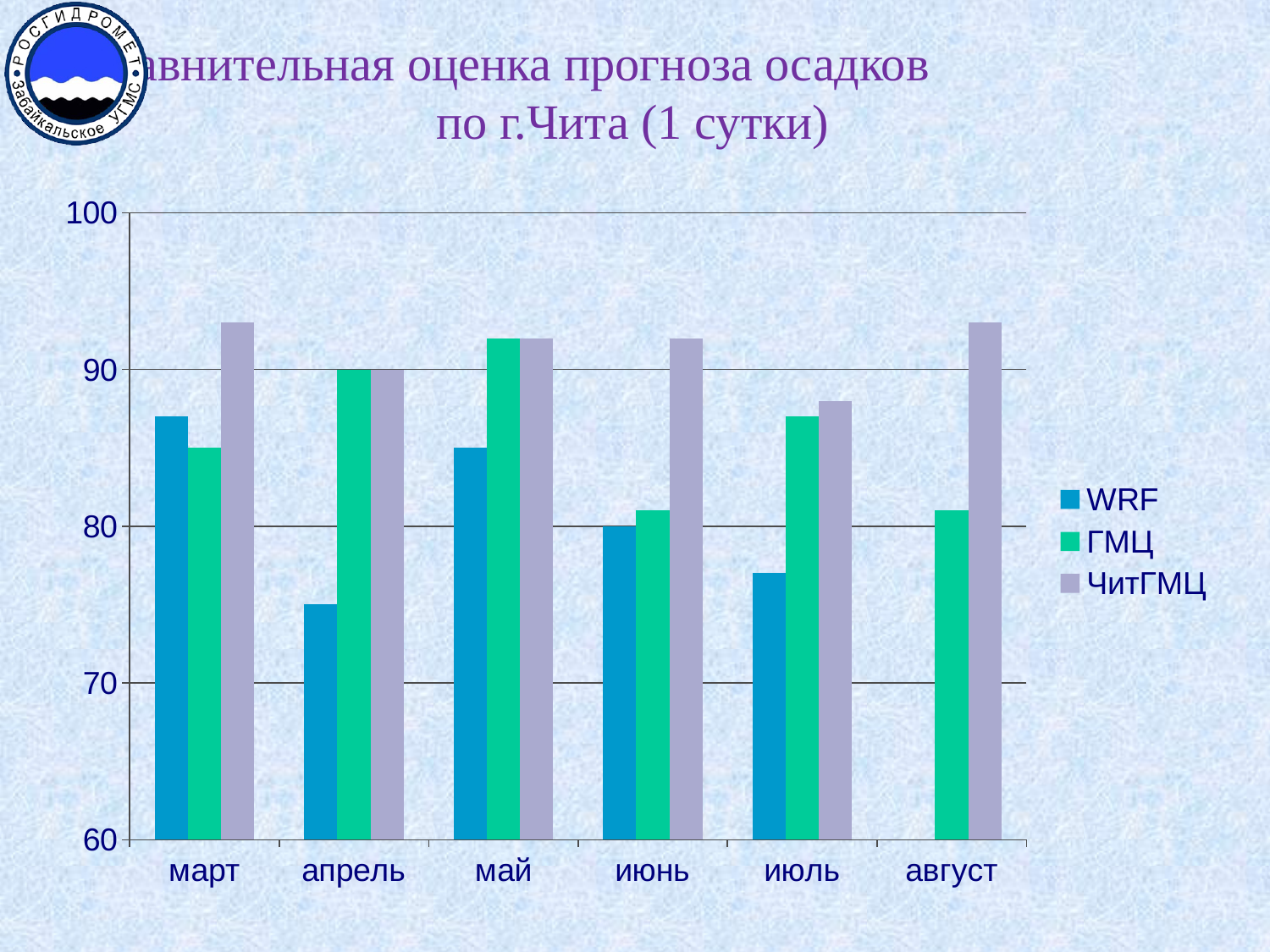
What is the value for WRF in июнь? 80 In июль, which is larger: the value for WRF or the value for ГМЦ? ГМЦ Which series has the lowest value in апрель? WRF Which series has the highest value in март? ЧитГМЦ What kind of chart is shown on the slide? bar chart Is the value for WRF in апрель greater or less than 80? less Is the value for WRF in июль greater or less than 80? less How many series does the legend list? 3 What is the value for ГМЦ in апрель? 90 How many months are shown on the x axis? 6 Is the value for ЧитГМЦ in июнь greater or less than 90? greater